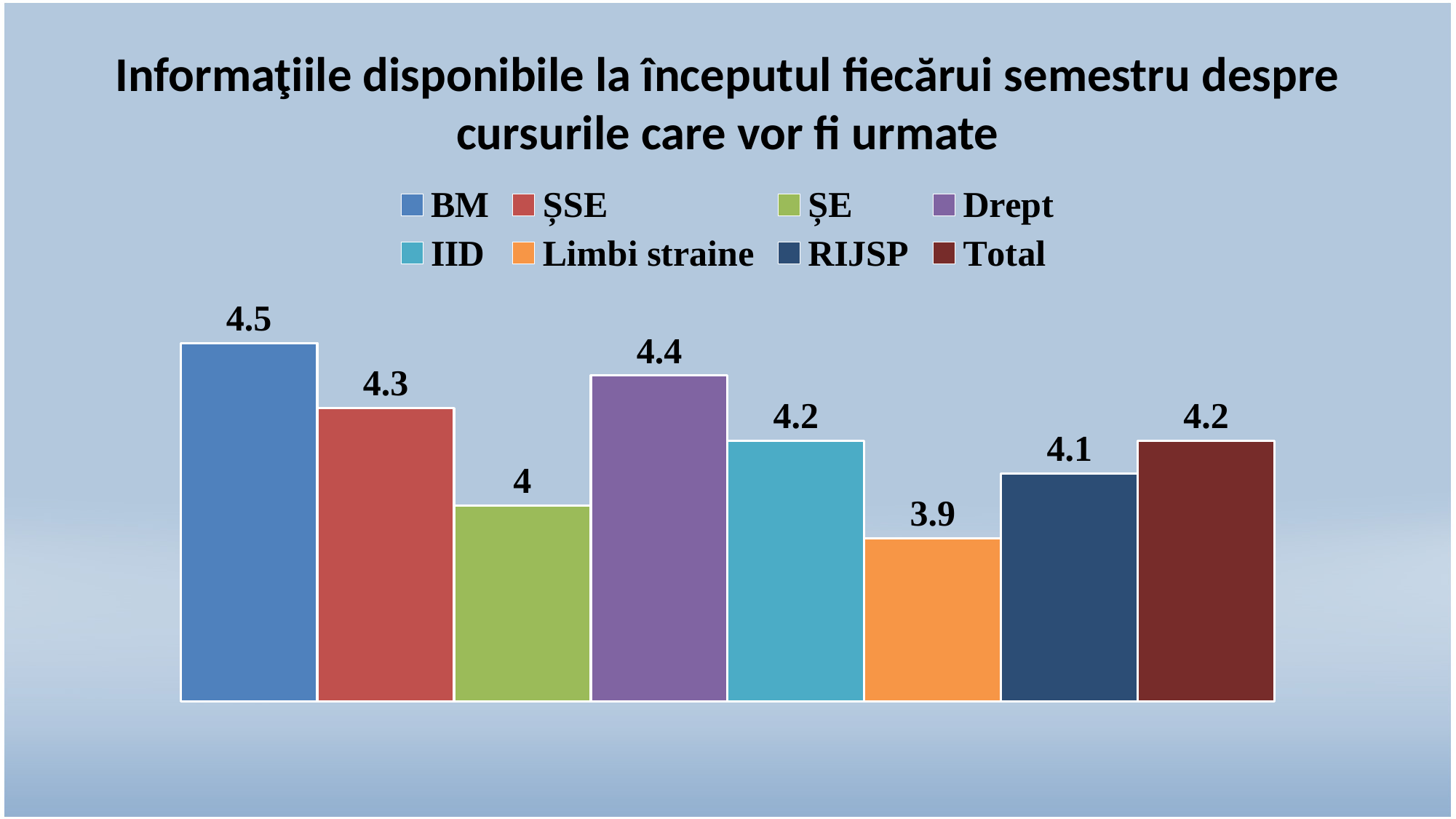
What kind of chart is shown on the slide? Bar chart What is the value for BM? 4.5 What is the difference between the values for BM and ȘE? 0.5 Which is larger, the value for ȘSE or the value for IID? ȘSE What is the difference between the values for Drept and Limbi straine? 0.5 What colour is the bar for Total? Dark red What is the value for Drept? 4.4 What is the value for RIJSP? 4.1 What is the value for Limbi straine? 3.9 Which series has the highest value? BM Which series has the lowest value? Limbi straine How many series does the legend list? 8